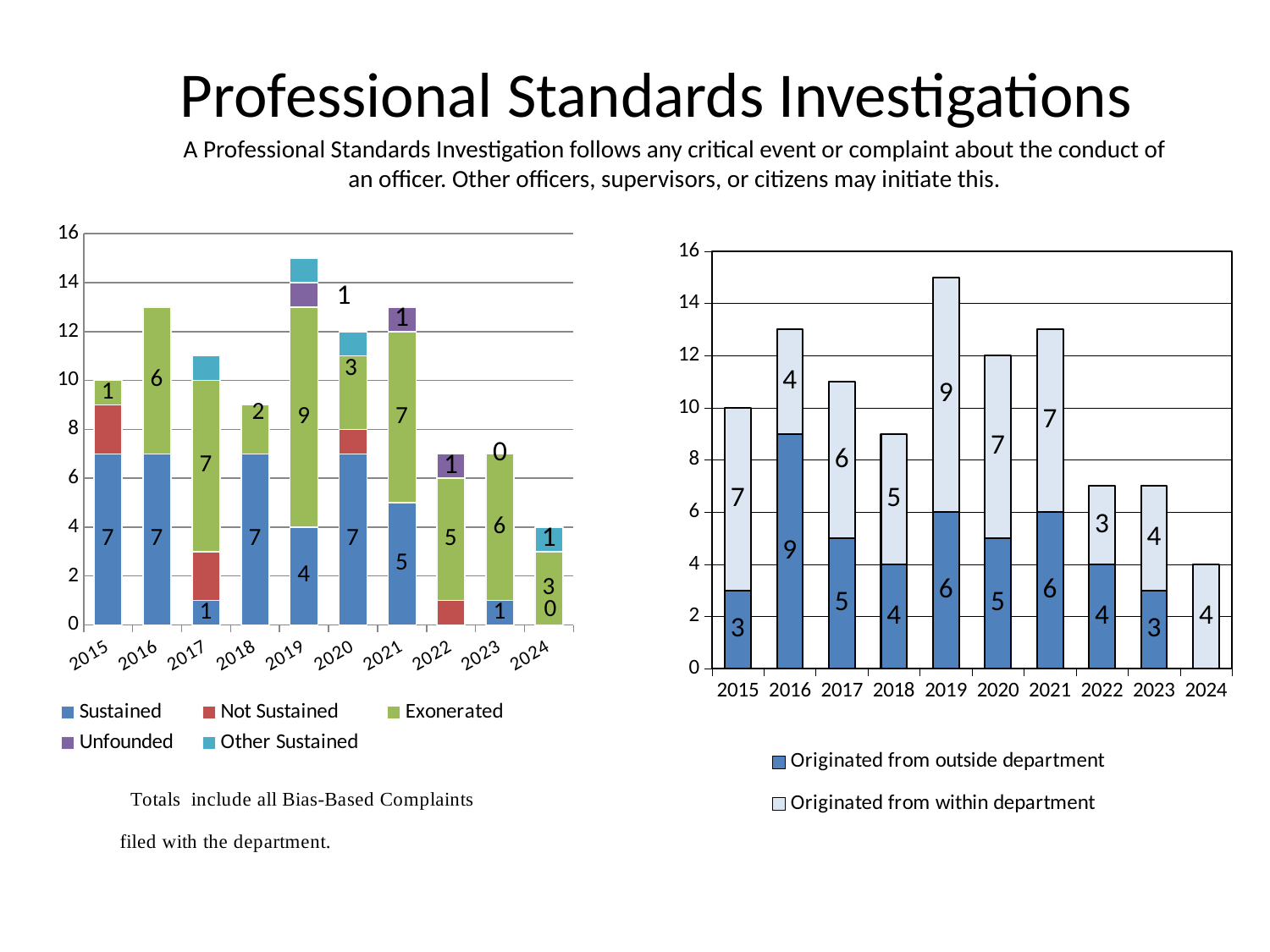
In the right chart, how many investigations originated from within the department in 2019? 9 What kind of chart is the left chart? Stacked bar chart In the right chart, how many series does the legend list? 2 In the right chart, how many investigations originated from outside the department in 2016? 9 In the right chart, what is the difference between investigations originated from within the department and from outside the department in 2015? 4 In the left chart, what is the Sustained value for 2021? 5 In the right chart, which year has the tallest stacked bar? 2019 In the right chart, what is the total height of the stacked bar for 2019? 15 In the right chart, what is the total height of the stacked bar for 2015? 10 In the left chart, what is the Exonerated value for 2019? 9 In the right chart, which year has the shortest stacked bar? 2024 In the left chart, how many series does the legend list? 5